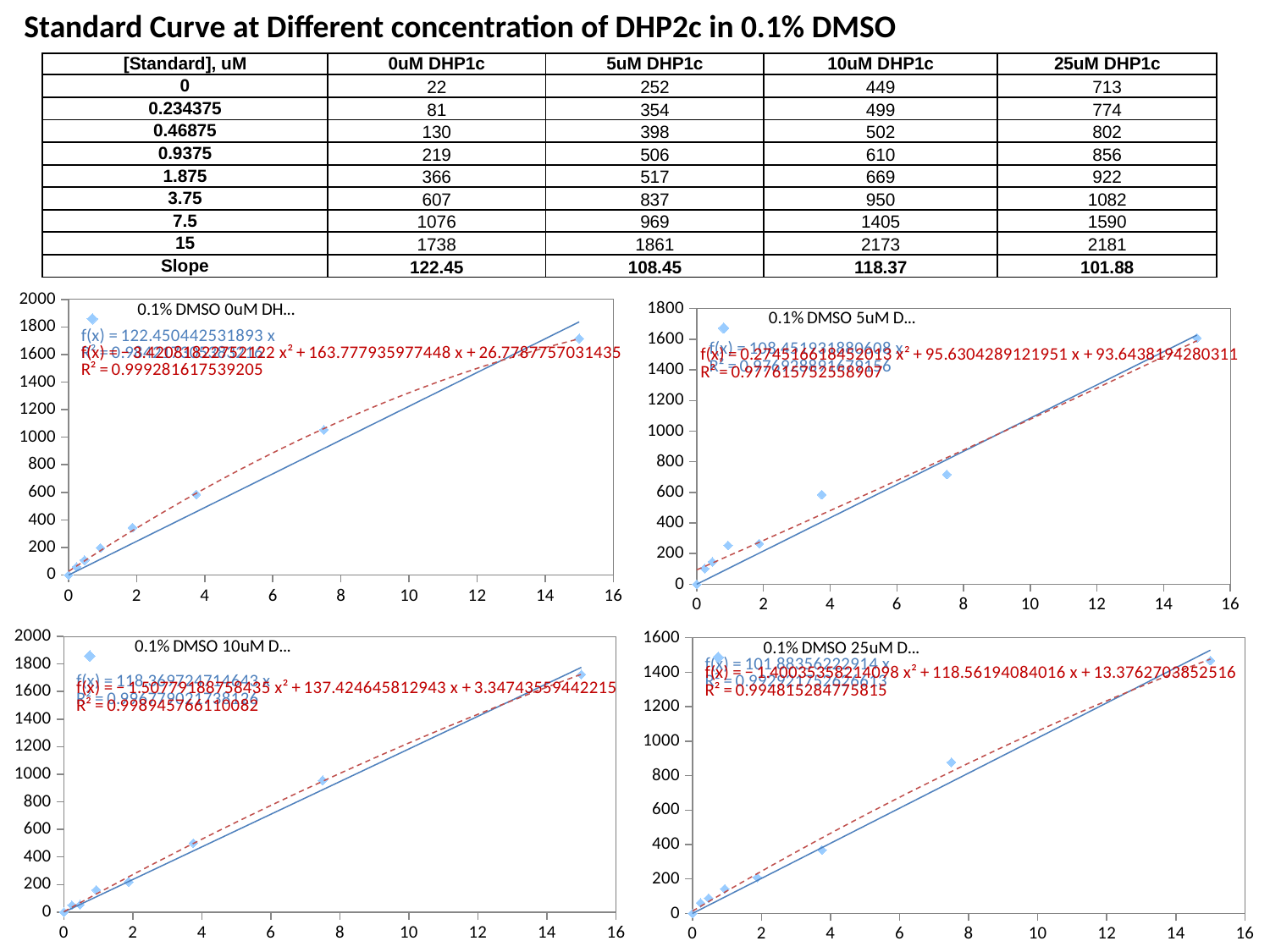
In the top-left chart (0.1% DMSO 0uM), do the plotted values rise or fall as x increases? rise In the bottom-left chart (0.1% DMSO 10uM), is the value of the point at x = 15 greater or less than 1600? greater In the bottom-right chart (0.1% DMSO 25uM), is the value of the point at x = 7.5 greater or less than 800? greater How many data points are plotted in the top-left chart (0.1% DMSO 0uM)? 8 In the top-right chart (0.1% DMSO 5uM), is the value of the point at x = 7.5 greater or less than 800? less How many data points are plotted in the bottom-right chart (0.1% DMSO 25uM)? 8 What R² value is printed in red for the dashed polynomial trendline in the top-left chart (0.1% DMSO 0uM)? R² = 0.999281617539205 What is the maximum value shown on the y axis of the bottom-right chart (0.1% DMSO 25uM)? 1600 What kind of chart is the top-left chart (0.1% DMSO 0uM)? scatter chart